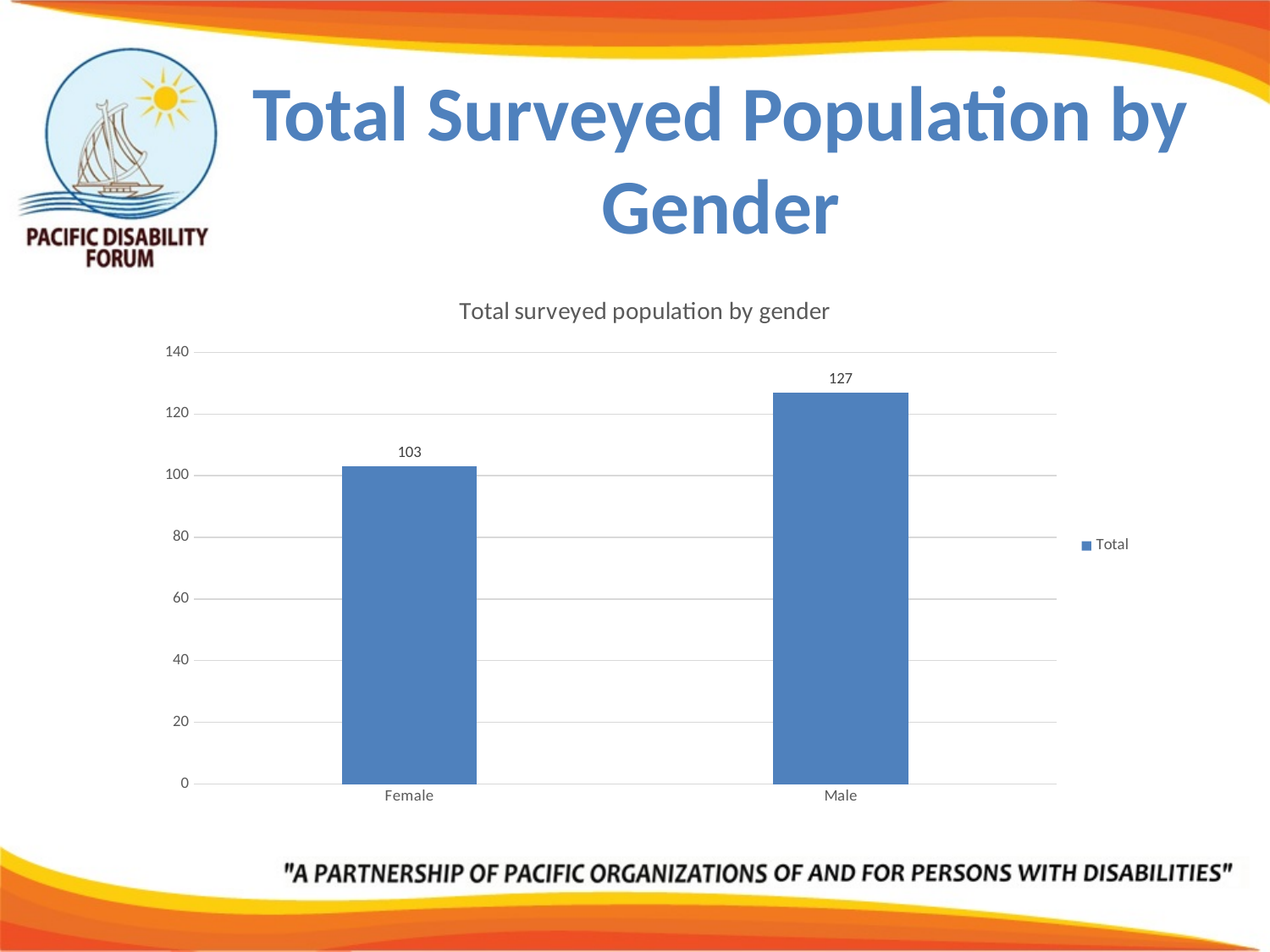
Which category has the lowest value? Female What is the value for Male? 127 Which category has the highest value? Male How many categories are shown on the x axis? 2 How many series does the legend list? 1 What kind of chart is shown? bar chart What is the title of the chart? Total surveyed population by gender What is the difference between the values for Male and Female? 24 What is the value for Female? 103 Is the value for Female greater or less than 120? less Which is larger, the value for Female or the value for Male? Male Is the value for Male greater or less than 120? greater